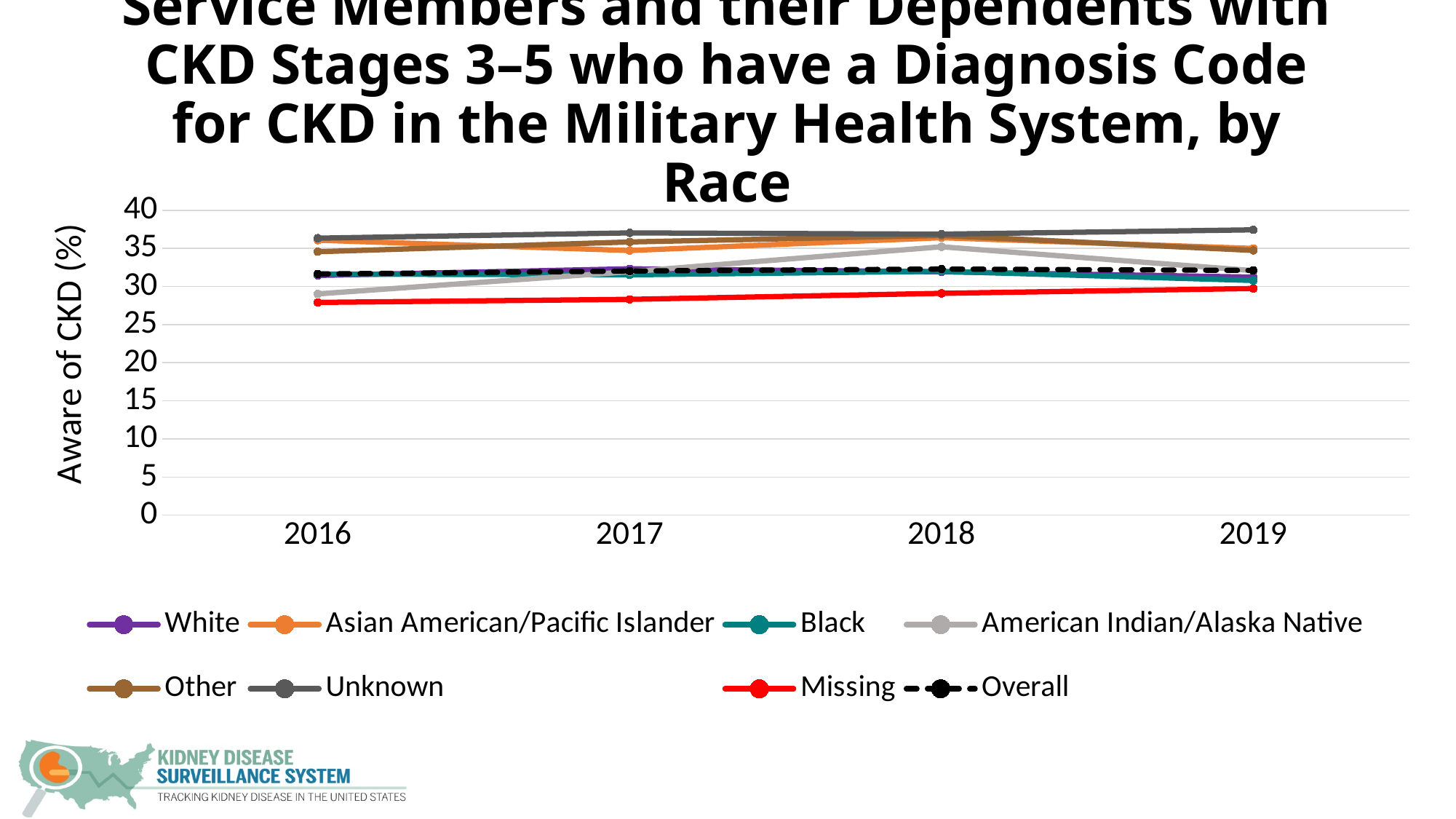
How many years are shown along the x axis? 4 Is the value for Unknown in 2019 greater or less than 35? greater Is the value for American Indian/Alaska Native in 2016 greater or less than 30? less How many series does the legend list? 8 In 2017, which is larger: the value for Asian American/Pacific Islander or the value for Black? Asian American/Pacific Islander What kind of chart is shown on the slide? line chart Which race group has the lowest CKD awareness in 2016? Missing What is the label on the y axis? Aware of CKD (%) Does the Missing line rise or fall from 2016 to 2019? rise Which race group has the highest CKD awareness in 2019? Unknown Is the value for Missing in 2016 greater or less than 30? less In 2018, which is larger: the value for Unknown or the value for Missing? Unknown